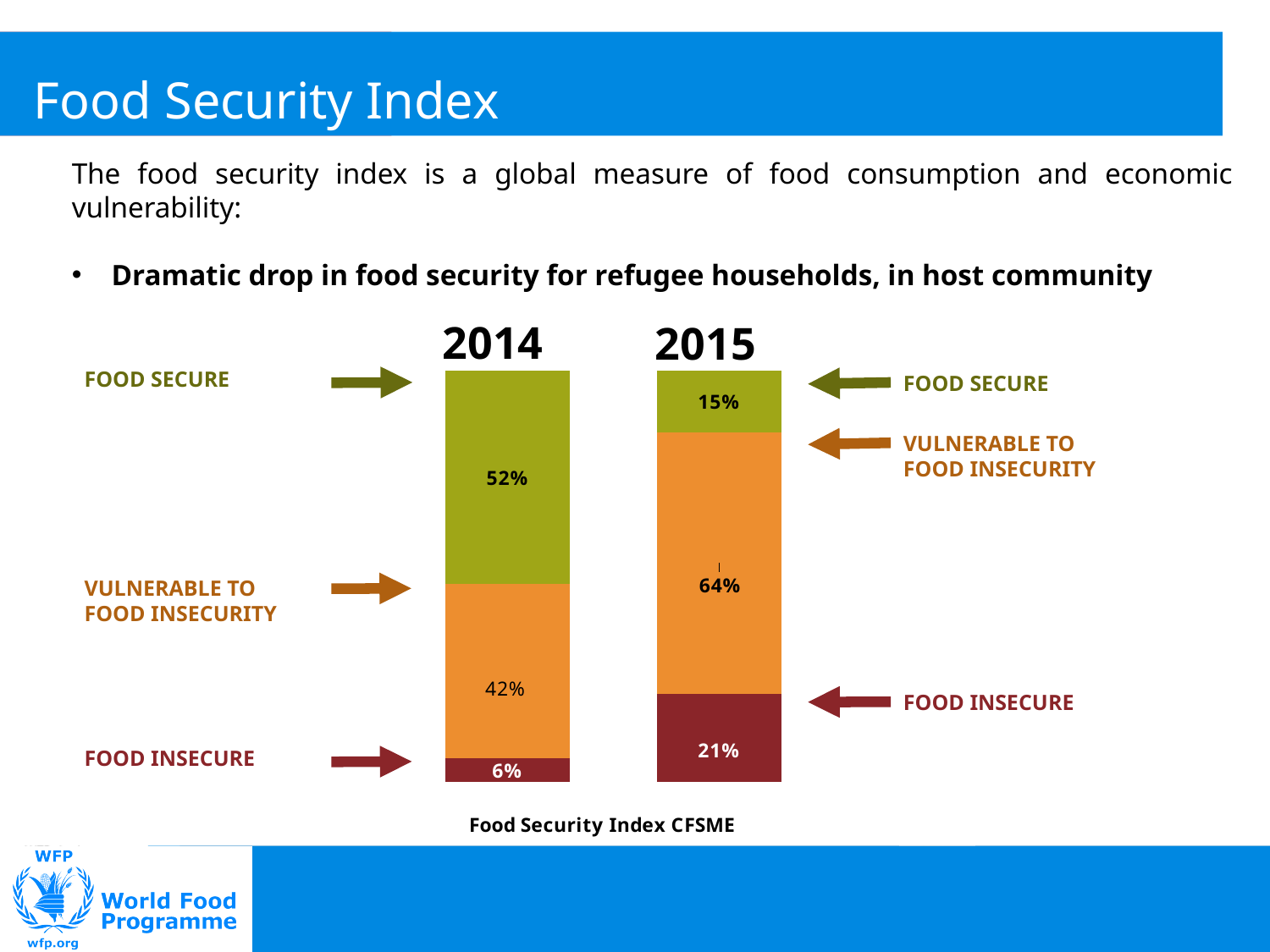
Which category had the largest share in 2015? Vulnerable to food insecurity What percentage of households were food secure in 2014? 52% What percentage of households were vulnerable to food insecurity in 2015? 64% Which category had the smallest share in 2014? Food insecure What percentage of households were food insecure in 2014? 6% What percentage of households were food insecure in 2015? 21% By how many percentage points did the food insecure share rise from 2014 to 2015? 15 What percentage of households were food secure in 2015? 15% What kind of chart is shown on the slide? Stacked bar chart By how many percentage points did the food secure share fall from 2014 to 2015? 37 What is the caption below the chart? Food Security Index CFSME Which is larger: the vulnerable to food insecurity share in 2014 or in 2015? 2015